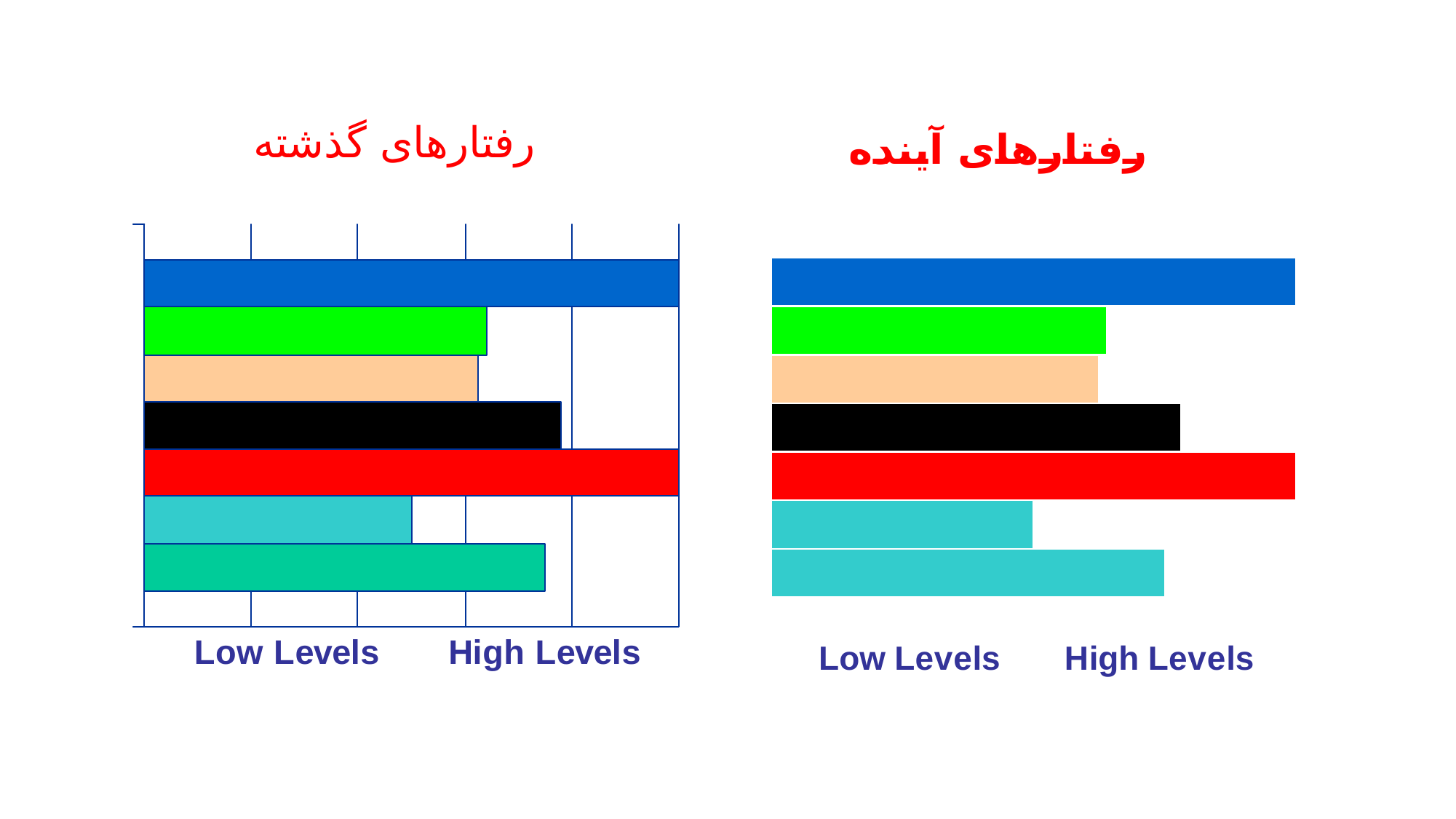
In the left chart titled "رفتارهای گذشته", which is longer, the green bar or the black bar? the black bar How many bars are plotted in the right chart titled "رفتارهای آینده"? 7 What are the two labels shown along the bottom of the left chart? Low Levels and High Levels What kind of chart is the left chart titled "رفتارهای گذشته"? bar chart In the left chart titled "رفتارهای گذشته", what colour is the shortest bar? cyan (light blue) In the right chart titled "رفتارهای آینده", which is longer, the black bar or the orange bar? the black bar In the right chart titled "رفتارهای آینده", which is longer, the blue bar or the green bar? the blue bar What kind of chart is the right chart titled "رفتارهای آینده"? bar chart How many bars are plotted in the left chart titled "رفتارهای گذشته"? 7 What is the title of the right chart? رفتارهای آینده